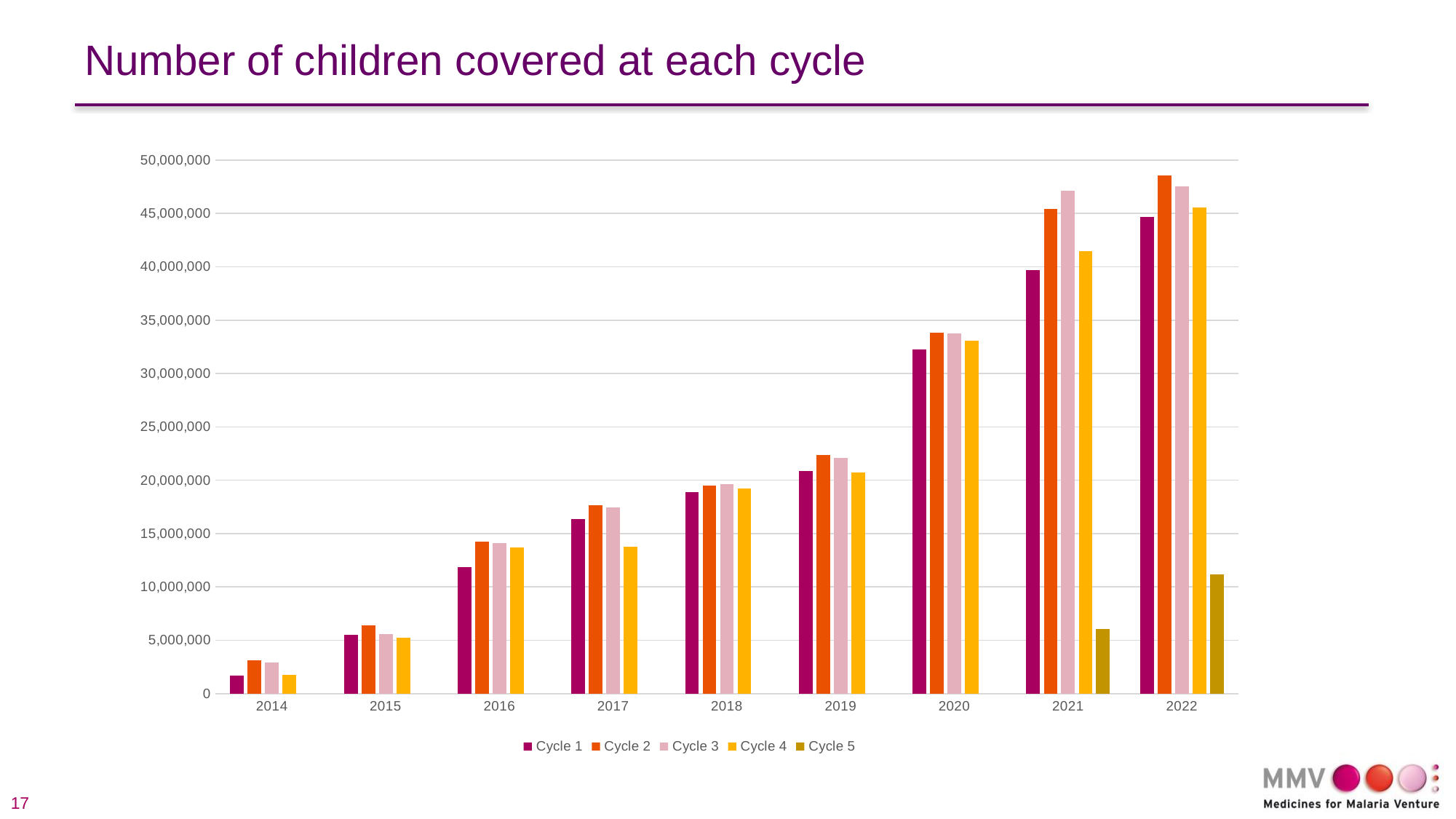
What kind of chart is shown on the slide? Bar chart Is the value for Cycle 5 in 2022 greater or less than 10,000,000? greater In which year is the Cycle 2 value lowest? 2014 Which cycle has the highest value in 2021? Cycle 3 Which is larger: Cycle 1 in 2017 or Cycle 4 in 2017? Cycle 1 Is the value for Cycle 1 in 2014 greater or less than 5,000,000? less Is the value for Cycle 4 in 2017 greater or less than 15,000,000? less Do the Cycle 1 values rise or fall from 2014 to 2021? rise In which year is the Cycle 1 value highest? 2022 How many series does the legend list? 5 How many years are shown on the x axis? 9